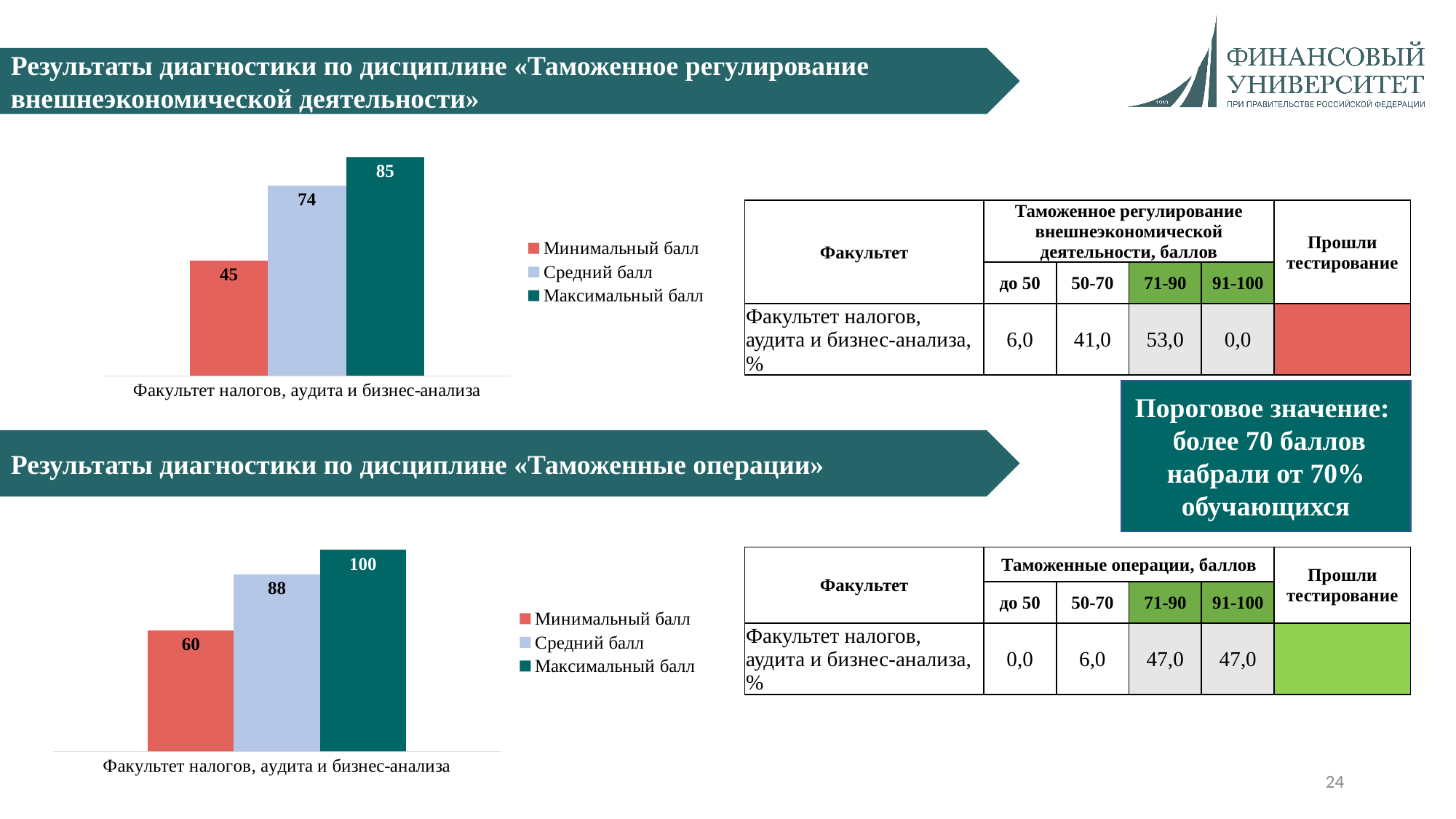
In the bottom chart (Таможенные операции), what is the value for Максимальный балл? 100 In the bottom chart (Таможенные операции), what is the value for Средний балл? 88 In the top chart (Таможенное регулирование внешнеэкономической деятельности), what is the value for Минимальный балл? 45 In the top chart (Таможенное регулирование внешнеэкономической деятельности), what is the value for Максимальный балл? 85 In the top chart (Таможенное регулирование внешнеэкономической деятельности), what is the difference between Максимальный балл and Минимальный балл? 40 In the bottom chart (Таможенные операции), what is the value for Минимальный балл? 60 In the top chart (Таможенное регулирование внешнеэкономической деятельности), which series has the lowest value? Минимальный балл How many series does the legend of the bottom chart (Таможенные операции) list? 3 What type of chart is the top chart (Таможенное регулирование внешнеэкономической деятельности)? Bar chart In the bottom chart (Таможенные операции), which series has the highest value? Максимальный балл In the bottom chart (Таможенные операции), what is the difference between Средний балл and Минимальный балл? 28 In the top chart (Таможенное регулирование внешнеэкономической деятельности), what is the value for Средний балл? 74